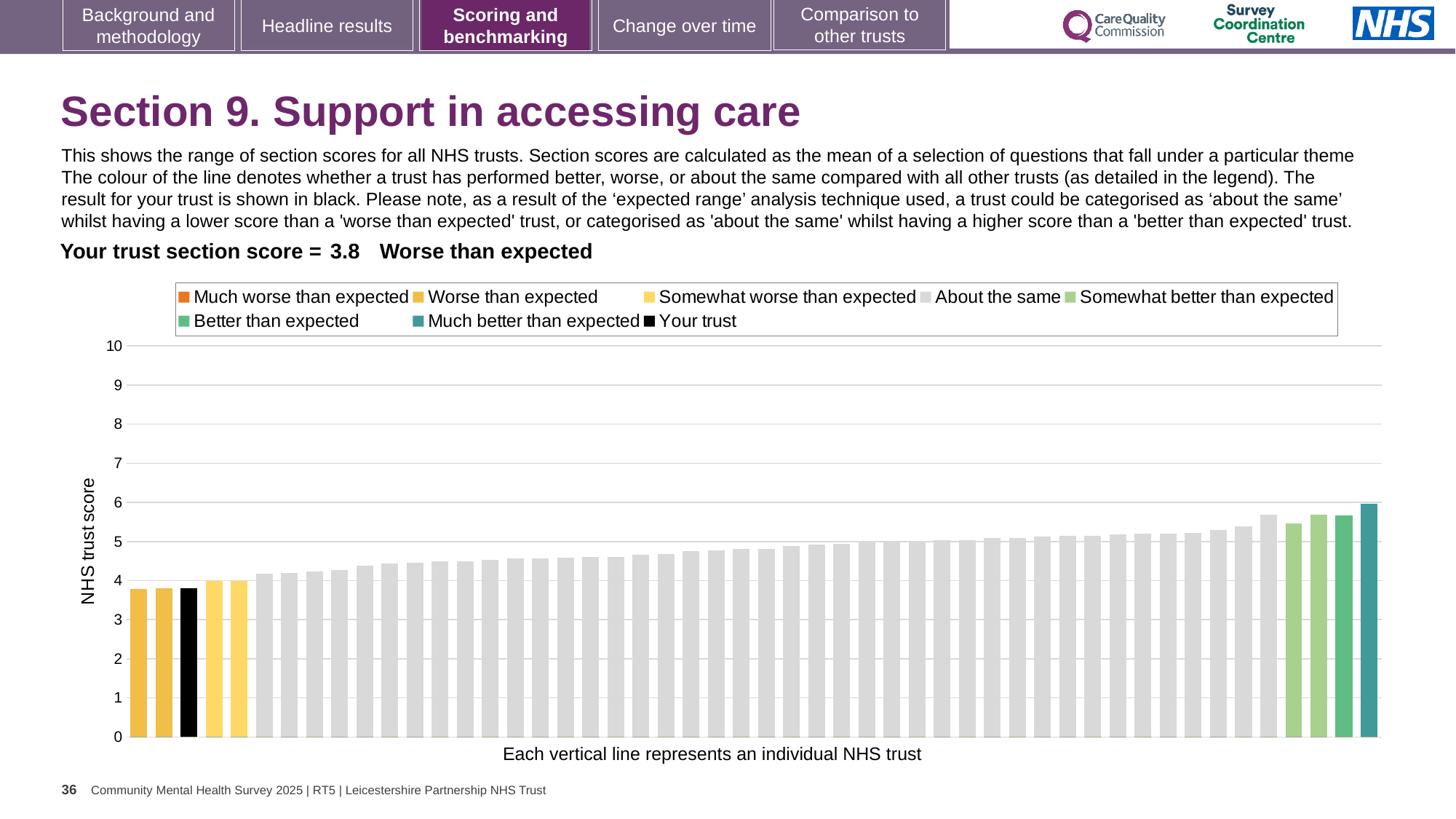
Do the trust scores rise or fall moving from left to right along the x axis? rise Is the value for the rightmost (tallest) trust bar greater or less than 5? greater What kind of chart is shown on the slide? Bar chart What colour is the bar representing your trust? Black How many entries does the chart legend list? 8 How is your trust's section score categorised on the slide? Worse than expected Is the value for the tallest grey 'About the same' bar greater or less than 6? less Is your trust's section score greater or less than 4? less What is the label on the vertical axis of the chart? NHS trust score Which is larger, the score of the leftmost bar or the score of the rightmost bar? the rightmost bar What is the section score for your trust shown on the slide? 3.8